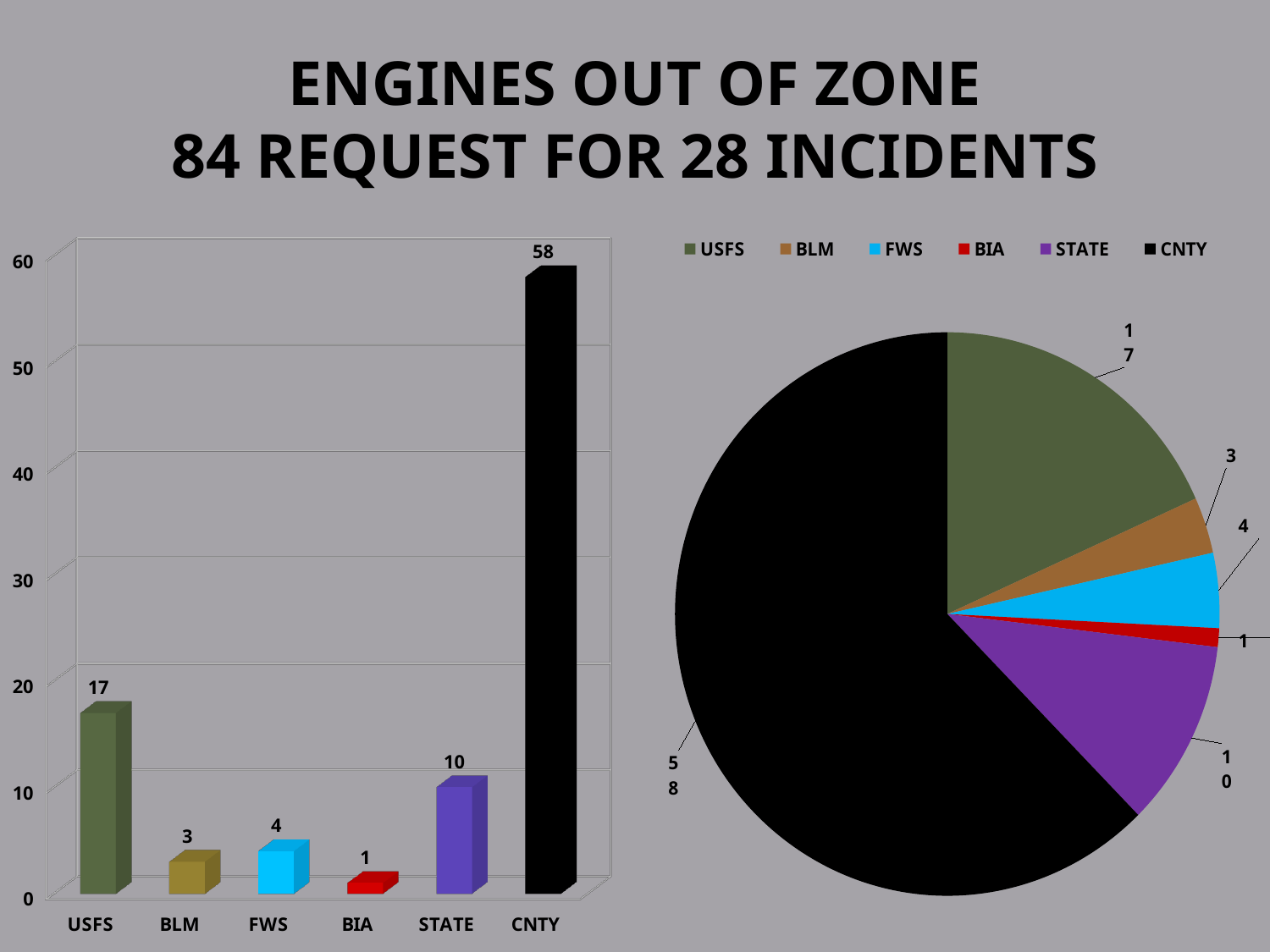
On the bar chart on the left, which category has the highest value? CNTY On the bar chart on the left, which category has the lowest value? BIA On the bar chart on the left, what is the difference between the values for CNTY and USFS? 41 On the bar chart on the left, what is the value for CNTY? 58 What kind of chart is on the left side of the slide? bar chart How many categories are shown on the bar chart on the left? 6 On the bar chart on the left, what is the value for USFS? 17 On the bar chart on the left, what is the value for STATE? 10 How many series does the legend of the pie chart on the right list? 6 On the bar chart on the left, which is larger, the value for FWS or the value for BLM? FWS On the bar chart on the left, is the value for CNTY greater or less than 50? greater On the pie chart on the right, what is the value of the BLM slice? 3